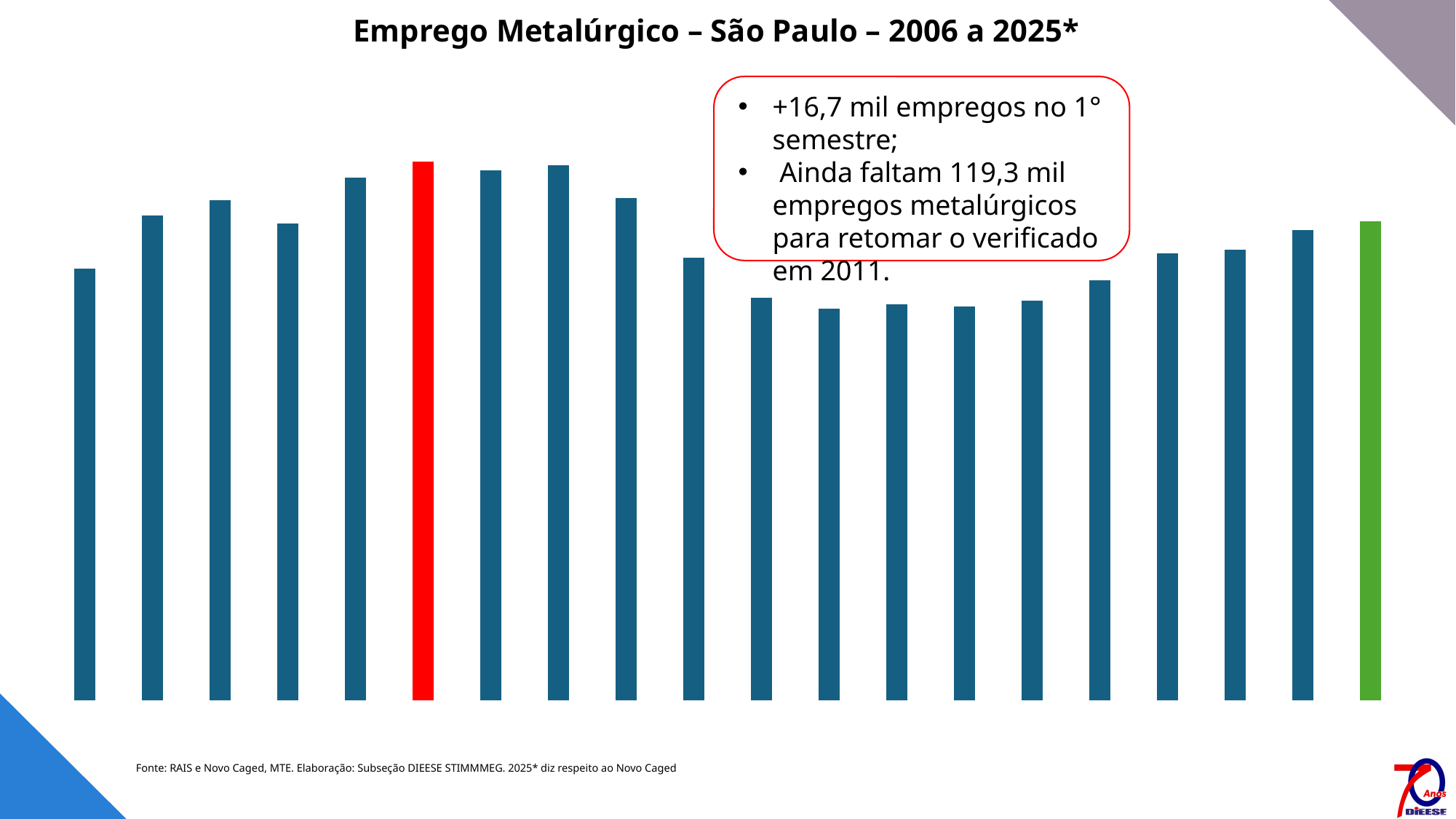
Do the bars rise or fall from the eighth bar to the twelfth bar? fall Which is taller, the red bar or the first bar on the left? the red bar What colour is the last bar on the right of the chart? green What kind of chart is shown on the slide? bar chart Which is taller, the third bar from the left or the twelfth bar from the left? the third bar Which is taller, the red bar or the green bar at the far right? the red bar How many bars does the chart contain? 20 Do the bars rise or fall from the fourteenth bar to the last bar on the right? rise What is the title of the chart? Emprego Metalúrgico – São Paulo – 2006 a 2025*